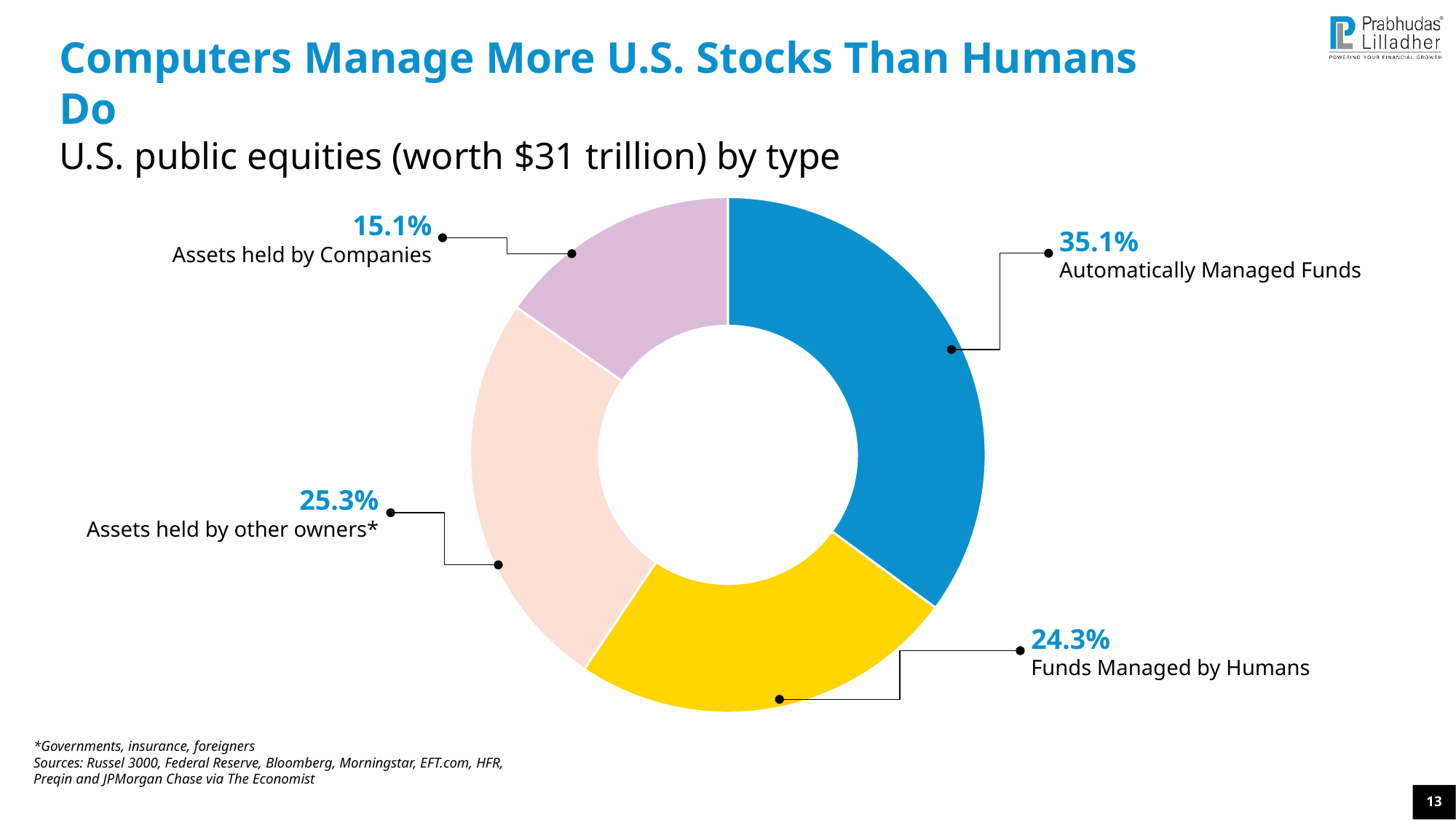
What percentage of U.S. public equities is shown as Assets held by other owners*? 25.3% What percentage of U.S. public equities is shown as Assets held by Companies? 15.1% By how many percentage points does the share of Automatically Managed Funds exceed that of Funds Managed by Humans? 10.8 Which is larger: the share of Assets held by other owners* or the share of Assets held by Companies? Assets held by other owners* Which category has the smallest share of U.S. public equities? Assets held by Companies Which category has the largest share of U.S. public equities? Automatically Managed Funds How many categories does the chart divide U.S. public equities into? 4 What colour is the slice for Funds Managed by Humans? Yellow What share of U.S. public equities is in Funds Managed by Humans? 24.3% What kind of chart is used on this slide? Pie chart (donut) What share of U.S. public equities is held in Automatically Managed Funds? 35.1% What is the combined share of Automatically Managed Funds and Funds Managed by Humans? 59.4%